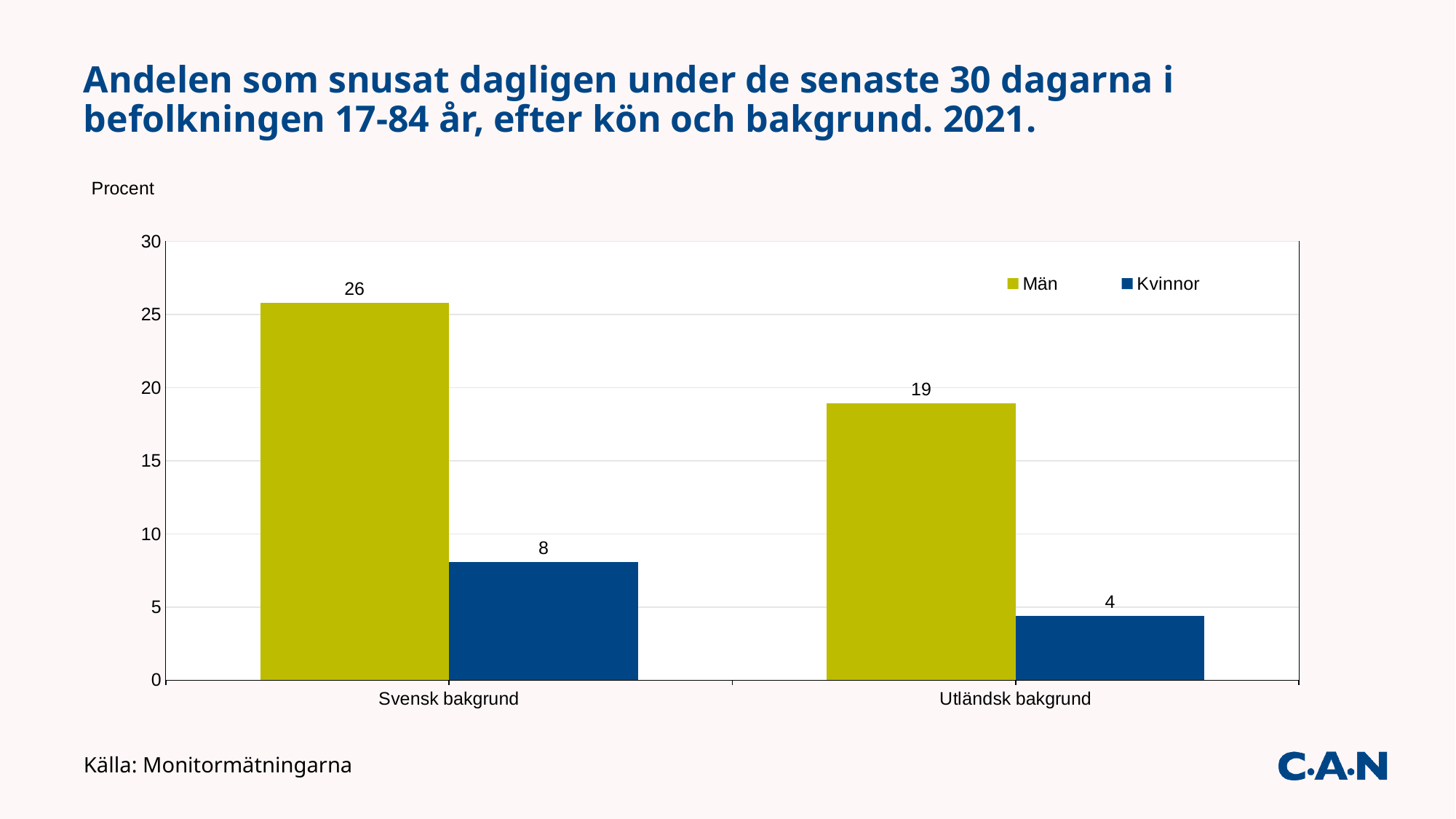
How many series does the legend list? 2 What is the value for Män in the Utländsk bakgrund category? 19 Which bar has the highest value on the chart? Män, Svensk bakgrund What is the difference between Män and Kvinnor in the Svensk bakgrund category? 18 What is the value for Kvinnor in the Utländsk bakgrund category? 4 What is the difference between the Män values for Svensk bakgrund and Utländsk bakgrund? 7 Which bar has the lowest value on the chart? Kvinnor, Utländsk bakgrund What kind of chart is shown on the slide? Bar chart What is the value for Kvinnor in the Svensk bakgrund category? 8 How many categories are shown on the x axis? 2 What is the value for Män in the Svensk bakgrund category? 26 Which is larger: Kvinnor for Svensk bakgrund or Kvinnor for Utländsk bakgrund? Kvinnor for Svensk bakgrund